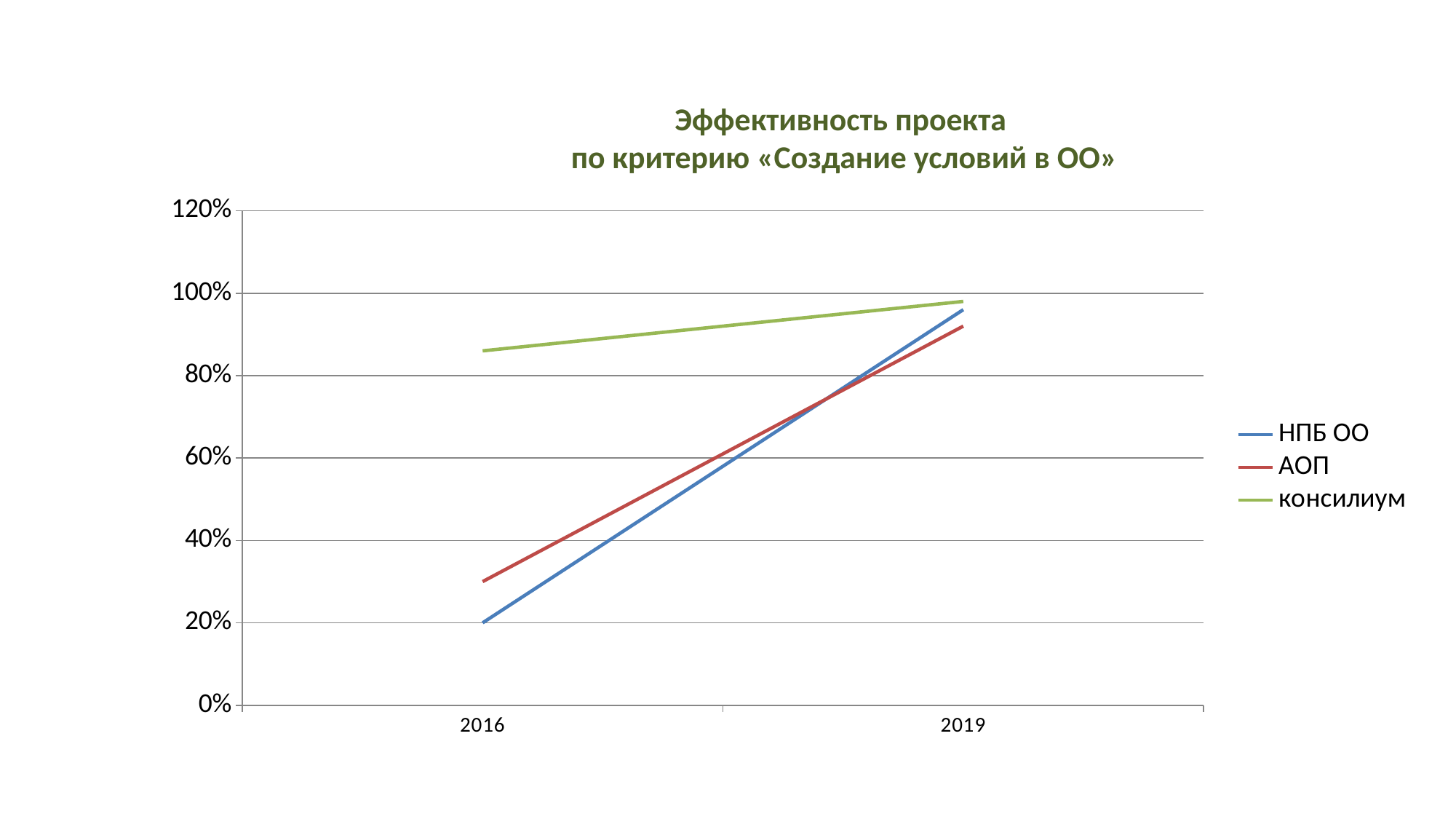
How many series does the legend list? 3 Which series has the highest value in 2016? консилиум Is the value for консилиум in 2016 greater or less than 80%? greater What is the value for НПБ ОО in 2016? 20% Does the value for НПБ ОО rise or fall from 2016 to 2019? rise What colour is the line for консилиум? green In 2016, which is larger: the value for АОП or the value for НПБ ОО? АОП Is the value for НПБ ОО in 2019 greater or less than 80%? greater Which series has the lowest value in 2016? НПБ ОО What kind of chart is shown on the slide? line chart Is the value for АОП in 2016 greater or less than 40%? less How many years are shown on the x axis? 2